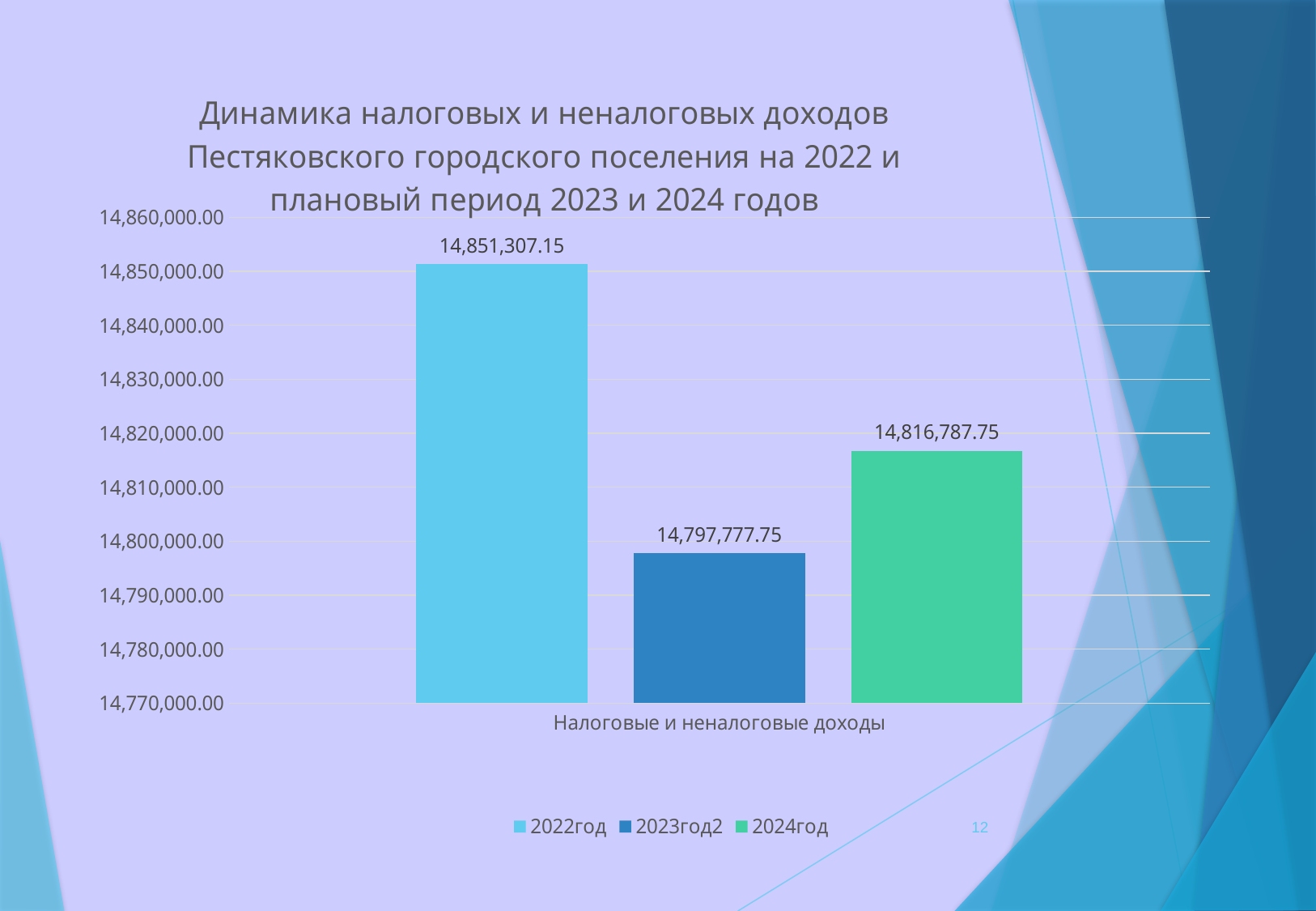
What is the value for 2022год? 14,851,307.15 What is the difference between the values for 2024год and 2023год2? 19,010.00 What kind of chart is shown on the slide? bar chart What is the value for 2024год? 14,816,787.75 What is the category label shown on the x axis? Налоговые и неналоговые доходы Which series has the highest value? 2022год Which series has the lowest value? 2023год2 Is the value for 2023год2 greater or less than 14,800,000.00? less Which is larger, the value for 2024год or the value for 2023год2? 2024год How many series does the legend list? 3 What is the difference between the values for 2022год and 2023год2? 53,529.40 What is the value for 2023год2? 14,797,777.75